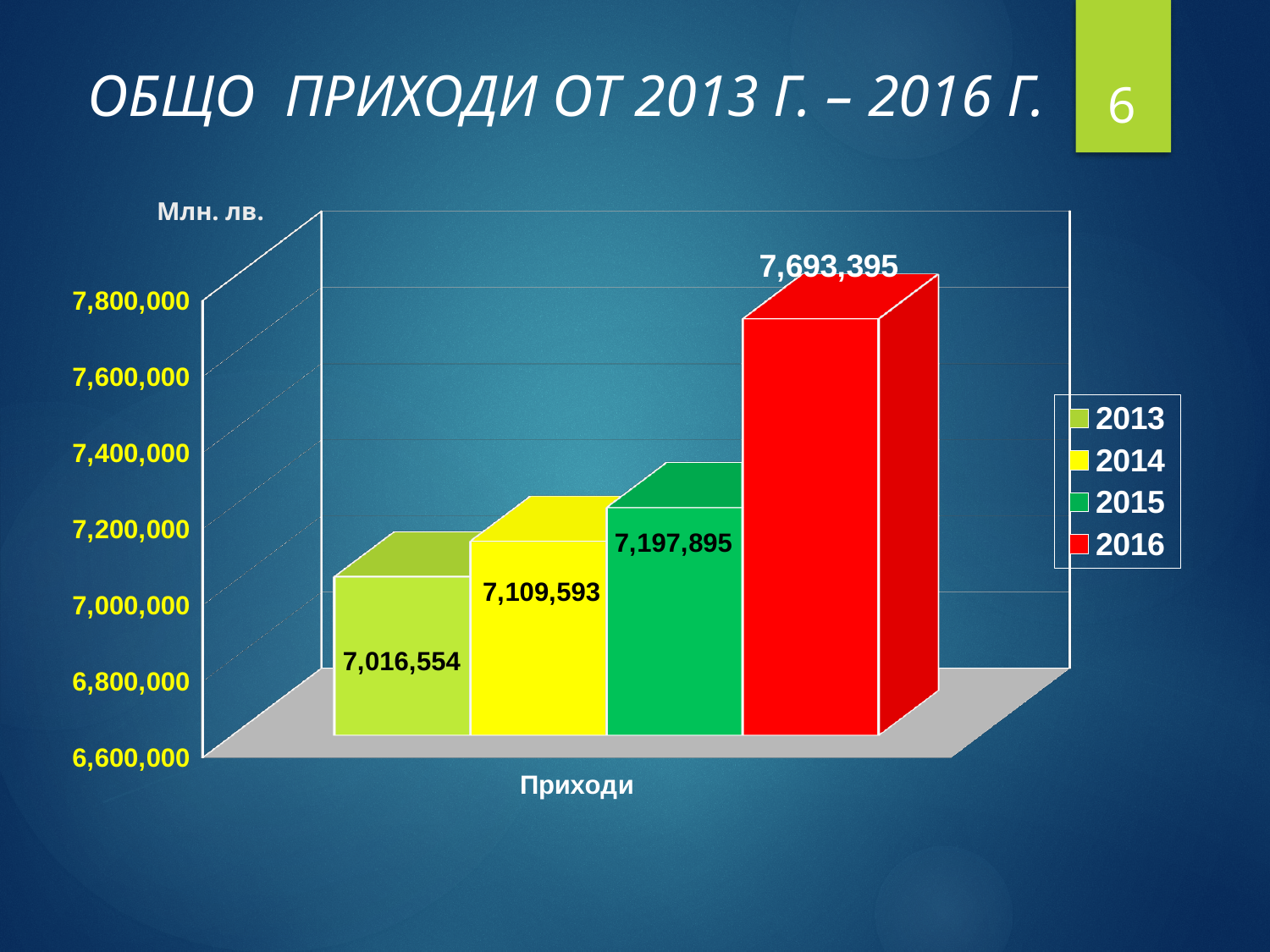
What is the value for 2015? 7,197,895 What is the difference between the values for 2016 and 2013? 676,841 Which year has the lowest value? 2013 How many series does the legend list? 4 Which year has the highest value? 2016 What kind of chart is shown on the slide? Bar chart Which is larger, the value for 2014 or the value for 2015? 2015 What is the value for 2014? 7,109,593 What is the title of the chart on the slide? ОБЩО ПРИХОДИ ОТ 2013 Г. – 2016 Г. What is the value for 2013? 7,016,554 What is the value for 2016? 7,693,395 What is the difference between the values for 2015 and 2014? 88,302